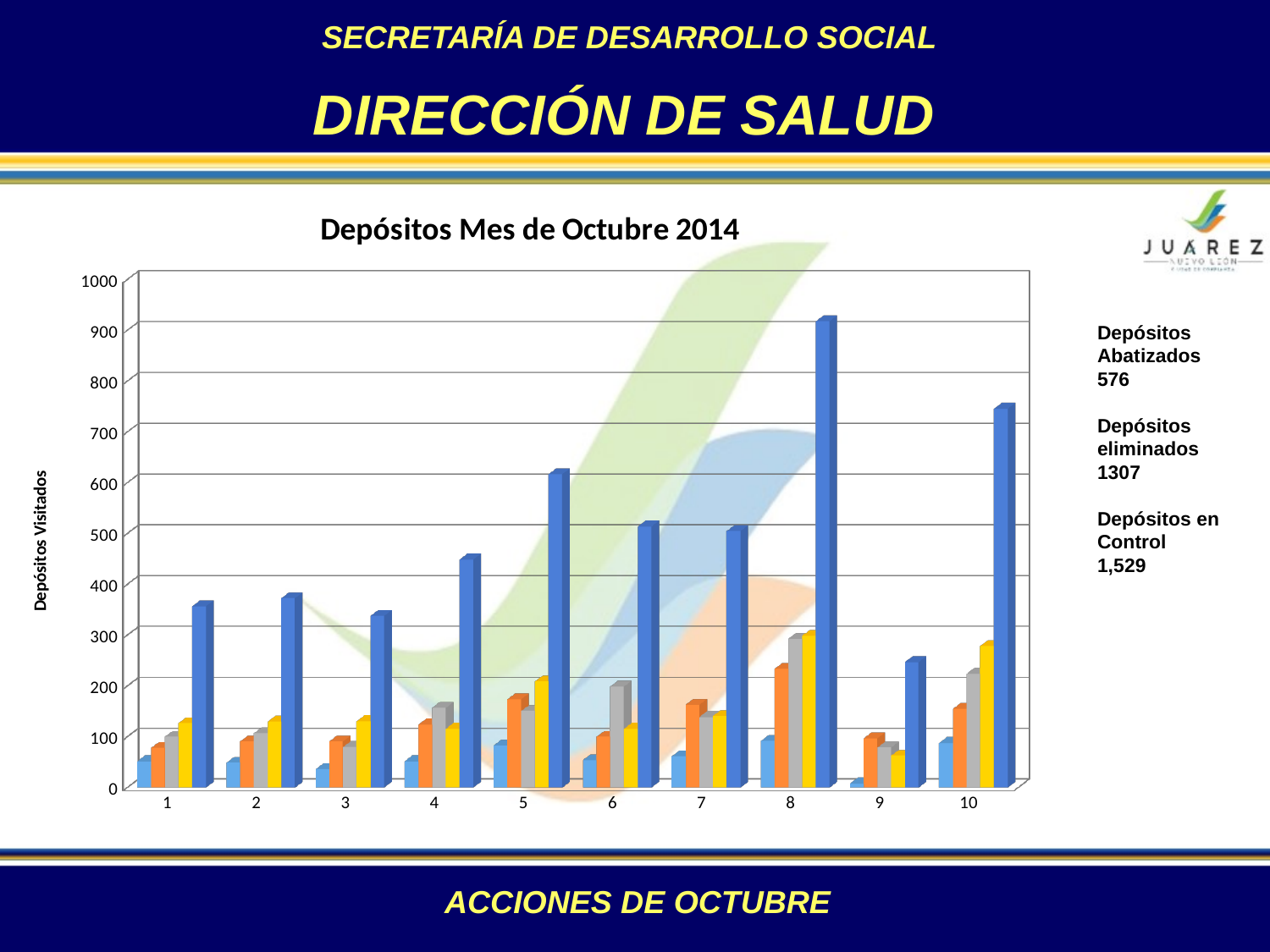
Is the dark blue bar for category 5 greater or less than 500? greater Which is larger, the dark blue bar for category 8 or the dark blue bar for category 10? category 8 How many categories are shown along the x axis of the chart? 10 What is the label on the vertical axis of the chart? Depósitos Visitados Is the dark blue bar for category 3 greater or less than 400? less Which category contains the tallest bar in the chart? 8 What is the title of the chart? Depósitos Mes de Octubre 2014 Is the dark blue bar for category 9 greater or less than 300? less Among the dark blue bars, which category has the lowest value? 9 Which is larger, the dark blue bar for category 1 or the dark blue bar for category 9? category 1 What kind of chart is shown on the slide? bar chart